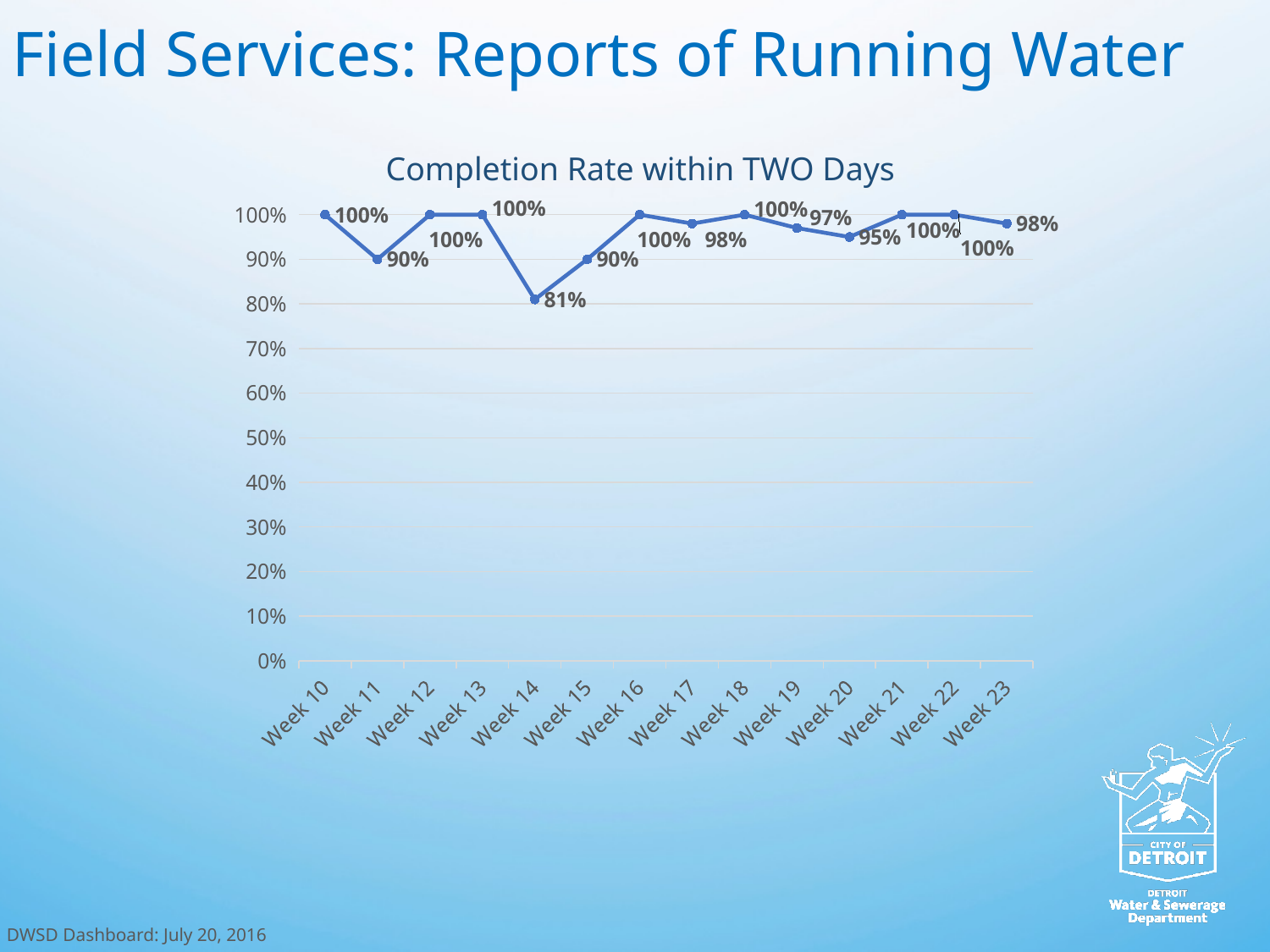
Does the completion rate rise or fall from Week 13 to Week 14? fall What type of chart is shown on the slide? line chart Is the value for Week 14 greater or less than 90%? less What is the completion rate for Week 23? 98% What is the completion rate for Week 20? 95% Which has a higher completion rate, Week 19 or Week 20? Week 19 What is the title of the chart? Completion Rate within TWO Days Which week has the lowest completion rate? Week 14 What is the completion rate for Week 11? 90% What is the completion rate for Week 14? 81% How many weeks are plotted on the x axis? 14 What is the difference in completion rate between Week 13 and Week 14? 19%